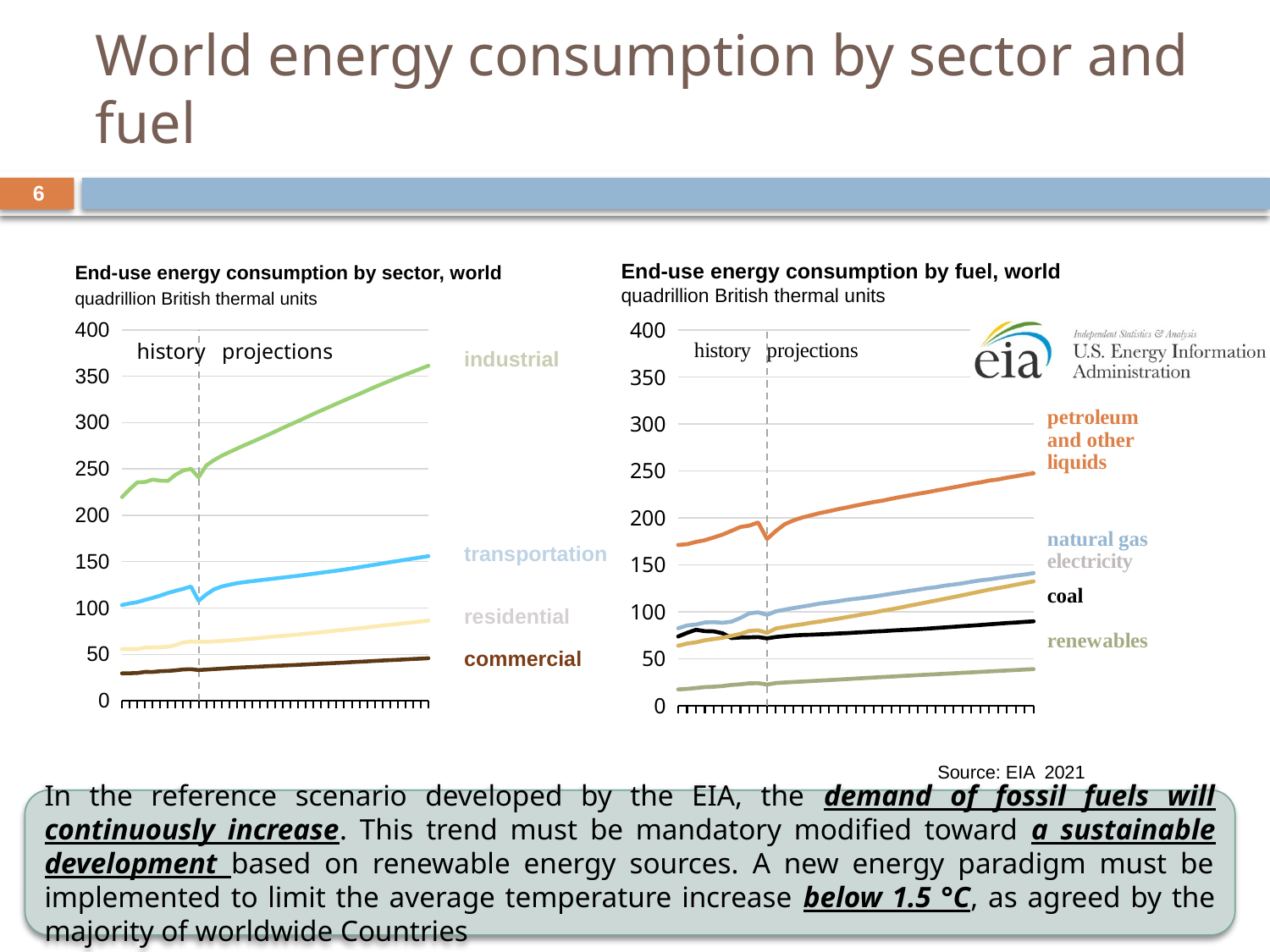
In the "End-use energy consumption by sector, world" chart, is the industrial value at the end of the projection period greater or less than 300? greater How many series are plotted in the "End-use energy consumption by fuel, world" chart? 5 In the "End-use energy consumption by sector, world" chart, which sector has the highest consumption throughout the period? industrial In the "End-use energy consumption by fuel, world" chart, does the petroleum and other liquids line rise or fall over the projection period? rise In the "End-use energy consumption by fuel, world" chart, which fuel has the lowest consumption throughout the period? renewables What type of chart is "End-use energy consumption by sector, world"? line chart What unit of measurement is stated under the title of the "End-use energy consumption by fuel, world" chart? quadrillion British thermal units How many series are plotted in the "End-use energy consumption by sector, world" chart? 4 In the "End-use energy consumption by fuel, world" chart, is the renewables value at the end of the projection period greater or less than 50? less In the "End-use energy consumption by sector, world" chart, which sector has the lowest consumption throughout the period? commercial In the "End-use energy consumption by sector, world" chart, is the commercial value at the end of the projection period greater or less than 50? less In the "End-use energy consumption by fuel, world" chart, which fuel has the highest consumption throughout the period? petroleum and other liquids